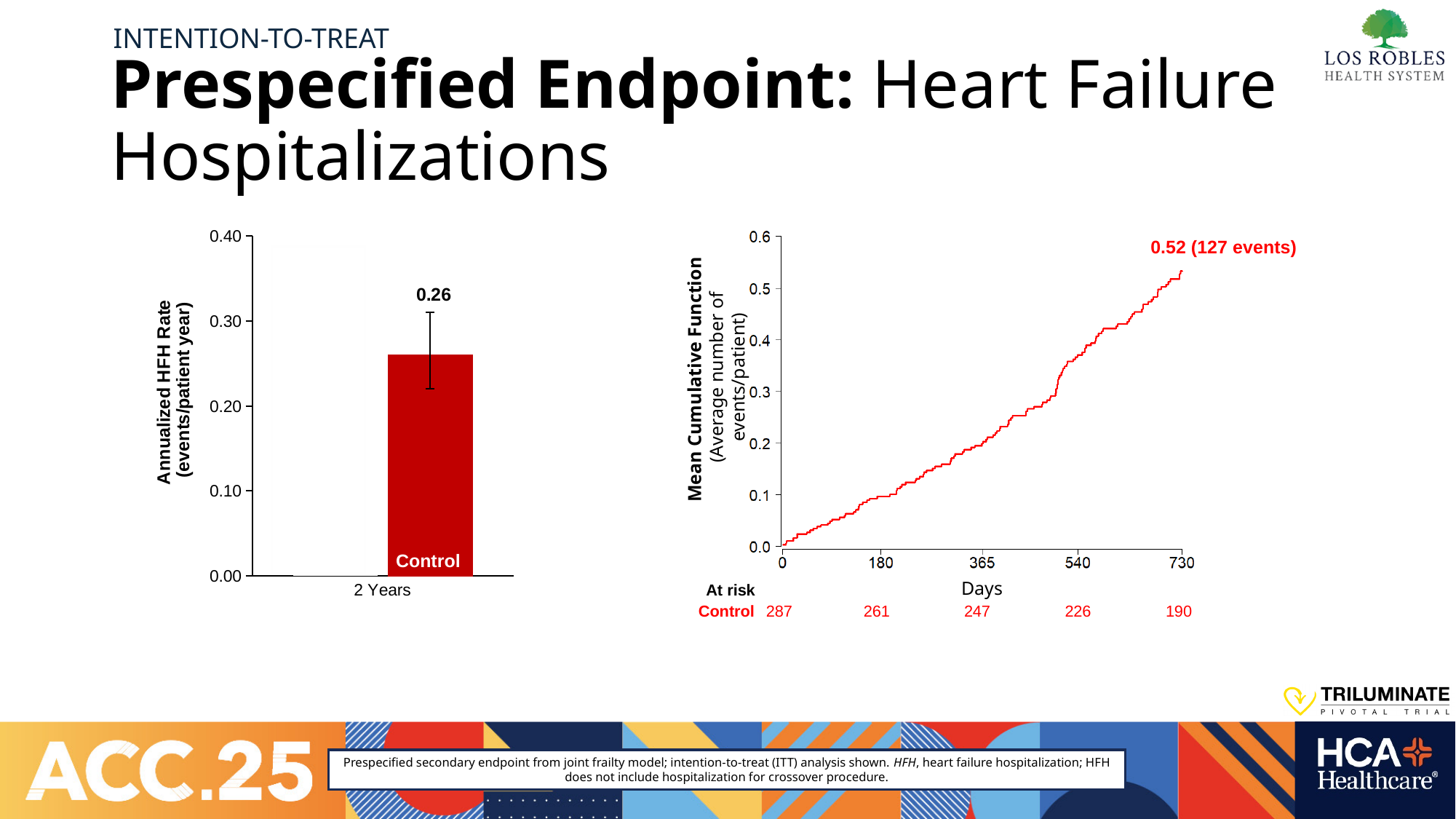
What kind of chart is the right chart showing the mean cumulative function? line chart In the left chart, what is the annualized HFH rate for the Control group at 2 years? 0.26 In the right chart, how many Control patients are at risk at day 730? 190 In the right chart, what is the mean cumulative function value labelled at the end of the curve? 0.52 (127 events) In the right chart, does the mean cumulative function rise or fall as days increase? rise In the left chart, how many bars are plotted? 1 In the left chart, is the Control bar value greater or less than 0.30? less In the right chart, how many events are reported in the label at the end of the curve? 127 events In the right chart, how many Control patients are at risk at day 0? 287 In the right chart, what is the difference between the number of Control patients at risk at day 0 and at day 730? 97 What kind of chart is the left chart showing the annualized HFH rate? bar chart In the left chart, what is the label on the x axis category? 2 Years